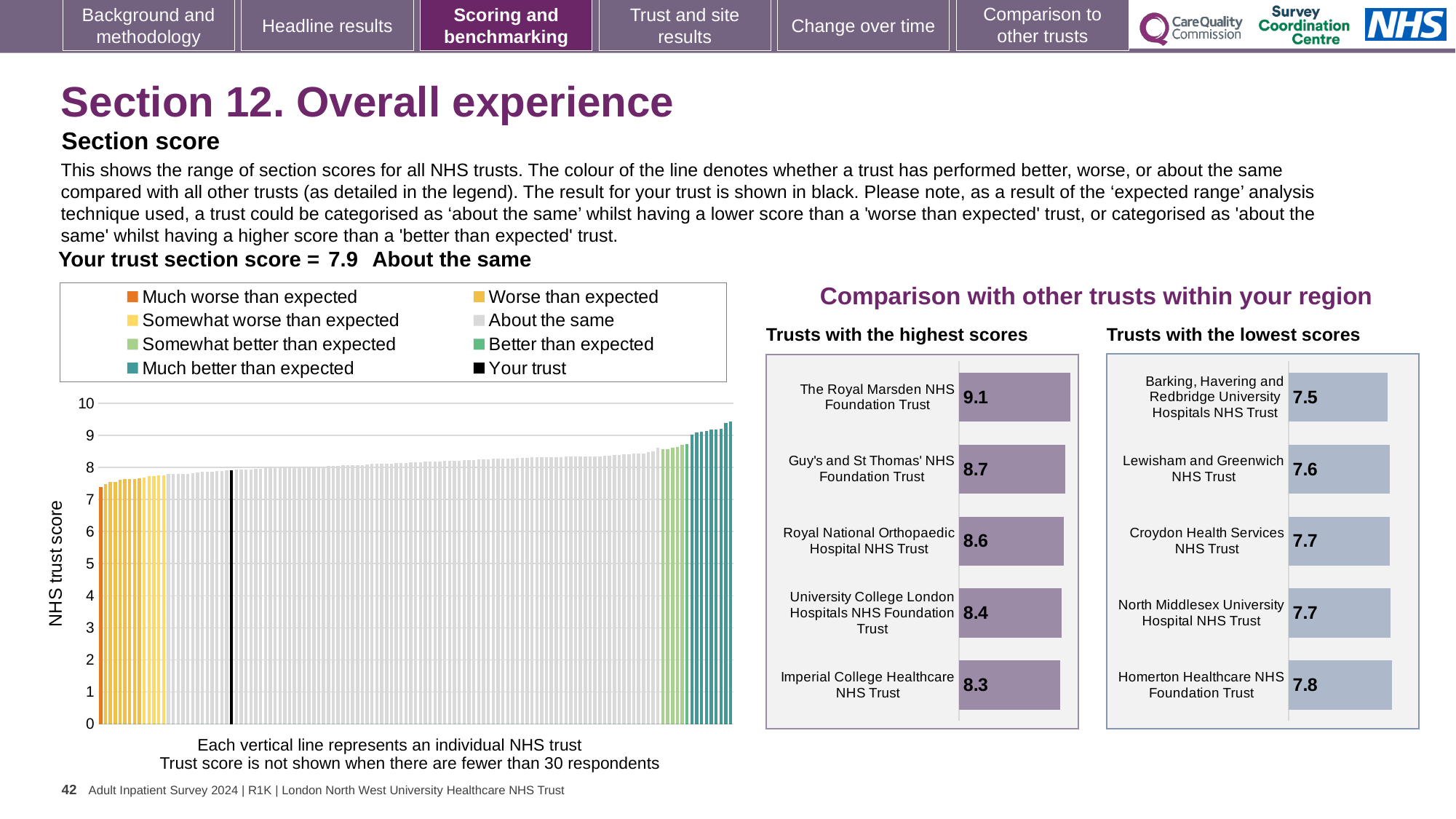
In the 'Trusts with the lowest scores' chart, what is the score for Croydon Health Services NHS Trust? 7.7 In the 'Trusts with the lowest scores' chart, which trust has the highest score? Homerton Healthcare NHS Foundation Trust In the 'Trusts with the highest scores' chart, what is the score for University College London Hospitals NHS Foundation Trust? 8.4 How many entries does the legend of the 'NHS trust score' chart on the left list? 8 In the 'Trusts with the highest scores' chart, what is the difference between the scores of The Royal Marsden NHS Foundation Trust and Imperial College Healthcare NHS Trust? 0.8 In the 'Trusts with the highest scores' chart, which trust has the highest score? The Royal Marsden NHS Foundation Trust In the 'Trusts with the highest scores' chart, which trust has the lowest score? Imperial College Healthcare NHS Trust In the 'Trusts with the lowest scores' chart, which has the larger score: Lewisham and Greenwich NHS Trust or Homerton Healthcare NHS Foundation Trust? Homerton Healthcare NHS Foundation Trust In the 'Trusts with the highest scores' chart, what is the score for The Royal Marsden NHS Foundation Trust? 9.1 In the 'Trusts with the lowest scores' chart, how many trusts are shown? 5 In the 'Trusts with the lowest scores' chart, which trust has the lowest score? Barking, Havering and Redbridge University Hospitals NHS Trust What type of chart is the 'NHS trust score' chart on the left of the slide? Bar chart